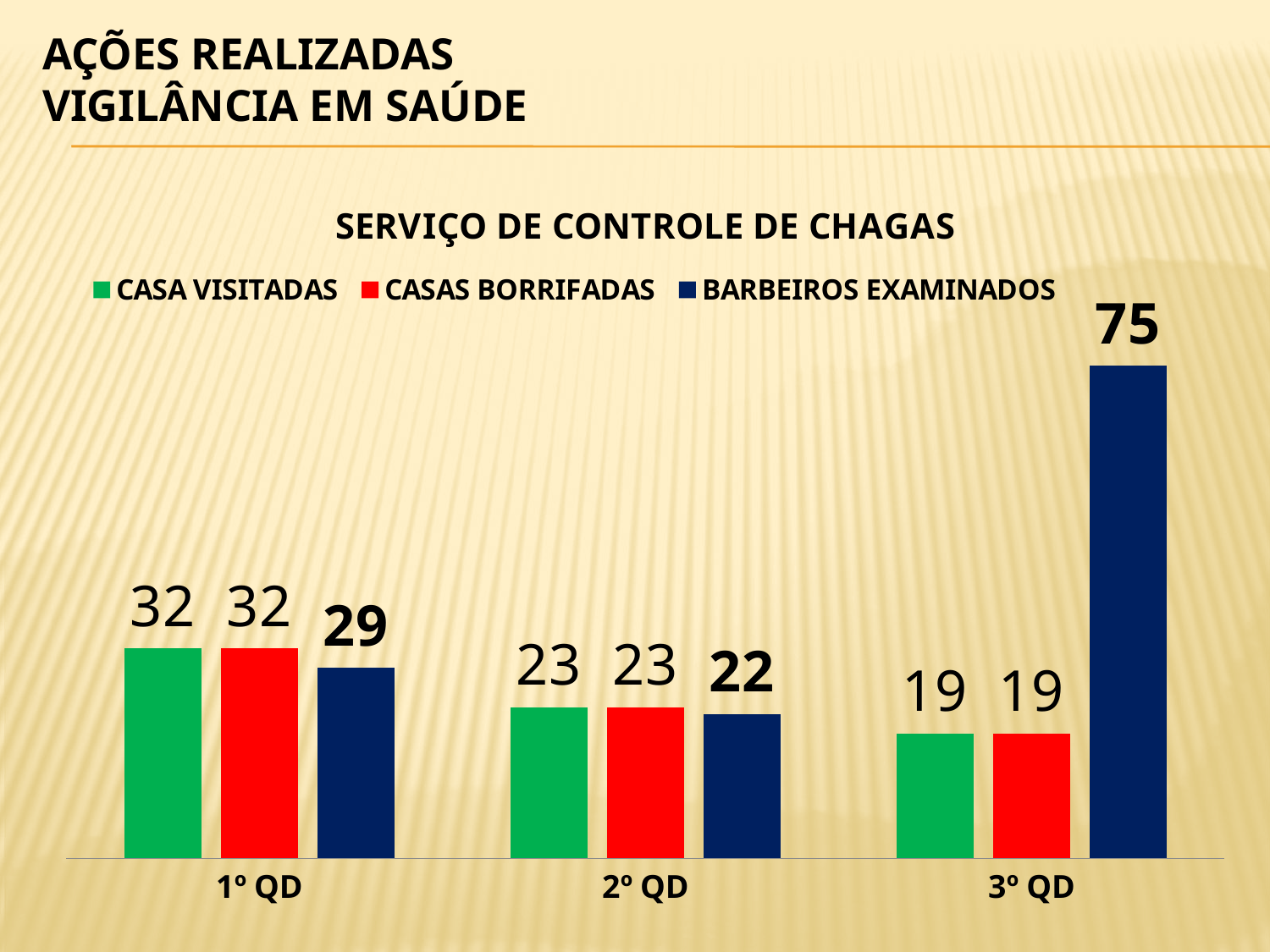
What is the title of the chart? SERVIÇO DE CONTROLE DE CHAGAS How many series does the legend list? 3 Which is larger: CASA VISITADAS in 1º QD or BARBEIROS EXAMINADOS in 1º QD? CASA VISITADAS in 1º QD What kind of chart is shown? bar chart In which quarter is CASA VISITADAS lowest? 3º QD What is the value for CASA VISITADAS in 1º QD? 32 What is the difference between BARBEIROS EXAMINADOS in 3º QD and in 2º QD? 53 In which quarter is BARBEIROS EXAMINADOS highest? 3º QD Do the values for CASAS BORRIFADAS rise or fall from 1º QD to 3º QD? fall How many quarters (categories) are shown on the x axis? 3 What is the value for BARBEIROS EXAMINADOS in 3º QD? 75 What is the value for CASAS BORRIFADAS in 2º QD? 23